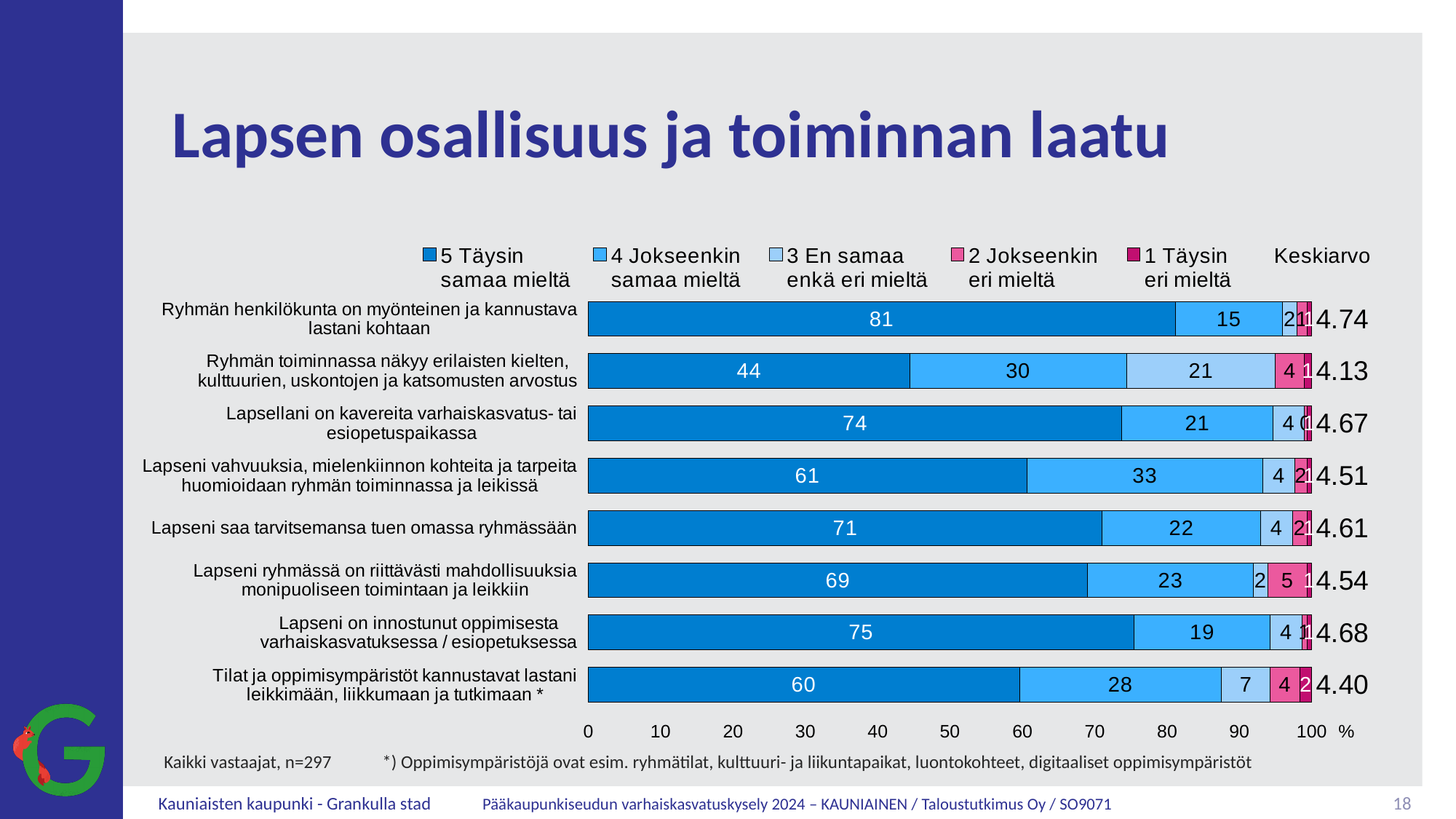
What is the difference in the "5 Täysin samaa mieltä" percentage between "Lapseni on innostunut oppimisesta varhaiskasvatuksessa / esiopetuksessa" and "Tilat ja oppimisympäristöt kannustavat lastani leikkimään, liikkumaan ja tutkimaan *"? 15 How many response categories does the legend list? 5 What percentage of respondents answered "5 Täysin samaa mieltä" for "Ryhmän henkilökunta on myönteinen ja kannustava lastani kohtaan"? 81 What percentage answered "3 En samaa enkä eri mieltä" for "Ryhmän toiminnassa näkyy erilaisten kielten, kulttuurien, uskontojen ja katsomusten arvostus"? 21 How many statements (bars) are shown in the chart? 8 What is the Keskiarvo (mean) shown for "Tilat ja oppimisympäristöt kannustavat lastani leikkimään, liikkumaan ja tutkimaan *"? 4.40 Which has a higher "5 Täysin samaa mieltä" percentage: "Lapseni saa tarvitsemansa tuen omassa ryhmässään" or "Lapseni ryhmässä on riittävästi mahdollisuuksia monipuoliseen toimintaan ja leikkiin"? Lapseni saa tarvitsemansa tuen omassa ryhmässään Which statement has the highest share of "5 Täysin samaa mieltä" responses? Ryhmän henkilökunta on myönteinen ja kannustava lastani kohtaan What is the sample size (n) stated below the chart? n=297 Which statement has the lowest Keskiarvo (mean) value? Ryhmän toiminnassa näkyy erilaisten kielten, kulttuurien, uskontojen ja katsomusten arvostus What type of chart is shown on the slide? Stacked bar chart What percentage answered "4 Jokseenkin samaa mieltä" for "Lapseni vahvuuksia, mielenkiinnon kohteita ja tarpeita huomioidaan ryhmän toiminnassa ja leikissä"? 33